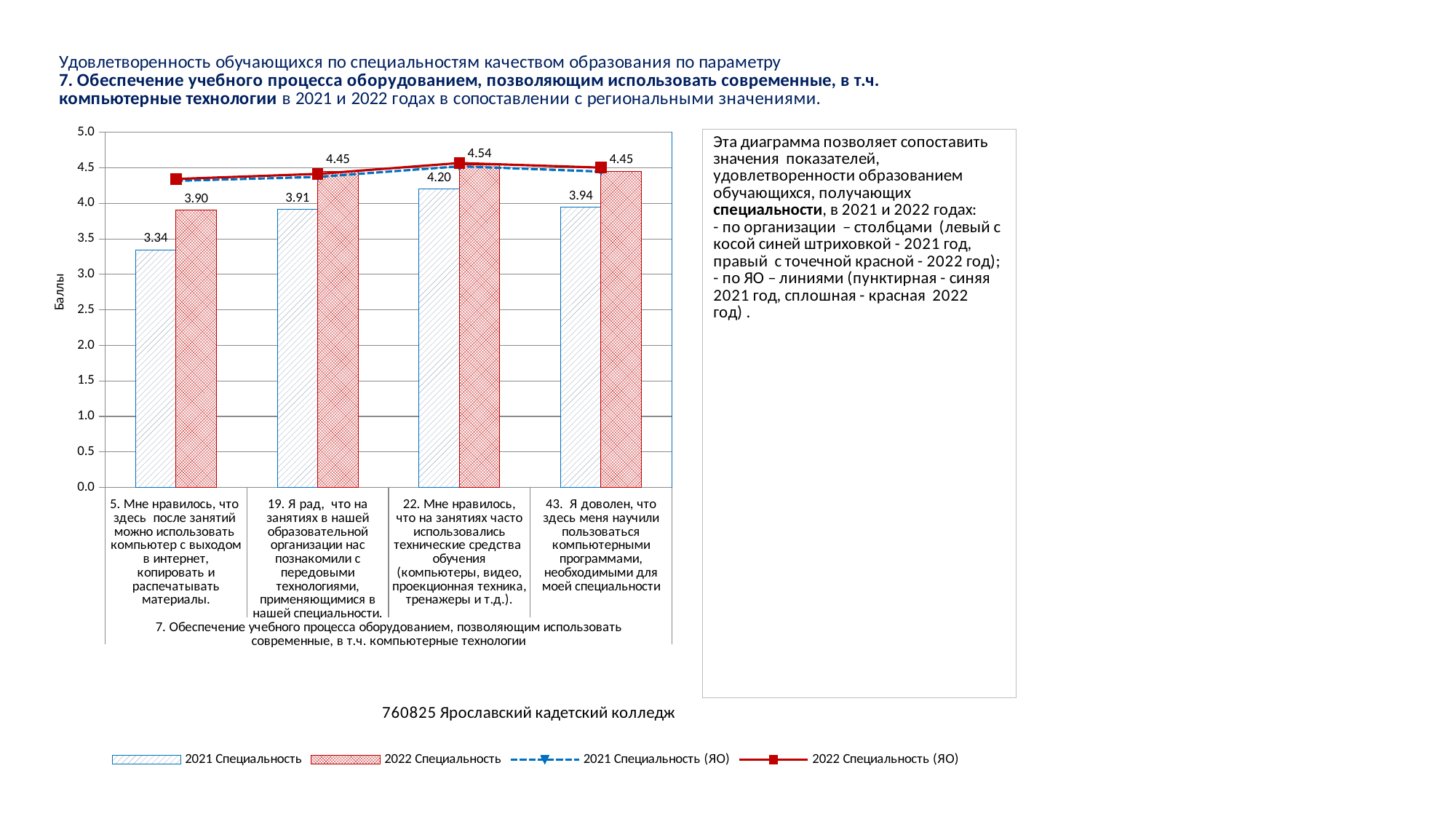
How many series does the legend list? 4 Which category has the lowest 2021 Специальность value? 5. Мне нравилось, что здесь после занятий можно использовать компьютер с выходом в интернет, копировать и распечатывать материалы. Which category has the highest 2022 Специальность value? 22. Мне нравилось, что на занятиях часто использовались технические средства обучения (компьютеры, видео, проекционная техника, тренажеры и т.д.). What is the 2021 Специальность value for question 5 ("Мне нравилось, что здесь после занятий можно использовать компьютер с выходом в интернет...")? 3.34 Which is larger for question 22: the 2021 Специальность value or the 2022 Специальность value? 2022 Специальность What is the difference between the 2022 and 2021 Специальность values for question 5? 0.56 What is the 2022 Специальность value for question 22 ("Мне нравилось, что на занятиях часто использовались технические средства обучения...")? 4.54 Is the 2021 Специальность (ЯО) line value for question 5 greater or less than 4.0? greater How many categories are shown on the x axis? 4 What is the label of the vertical axis? Баллы What is the 2021 Специальность value for question 43 ("Я доволен, что здесь меня научили пользоваться компьютерными программами...")? 3.94 What is the 2022 Специальность value for question 19 ("Я рад, что на занятиях в нашей образовательной организации нас познакомили с передовыми технологиями...")? 4.45